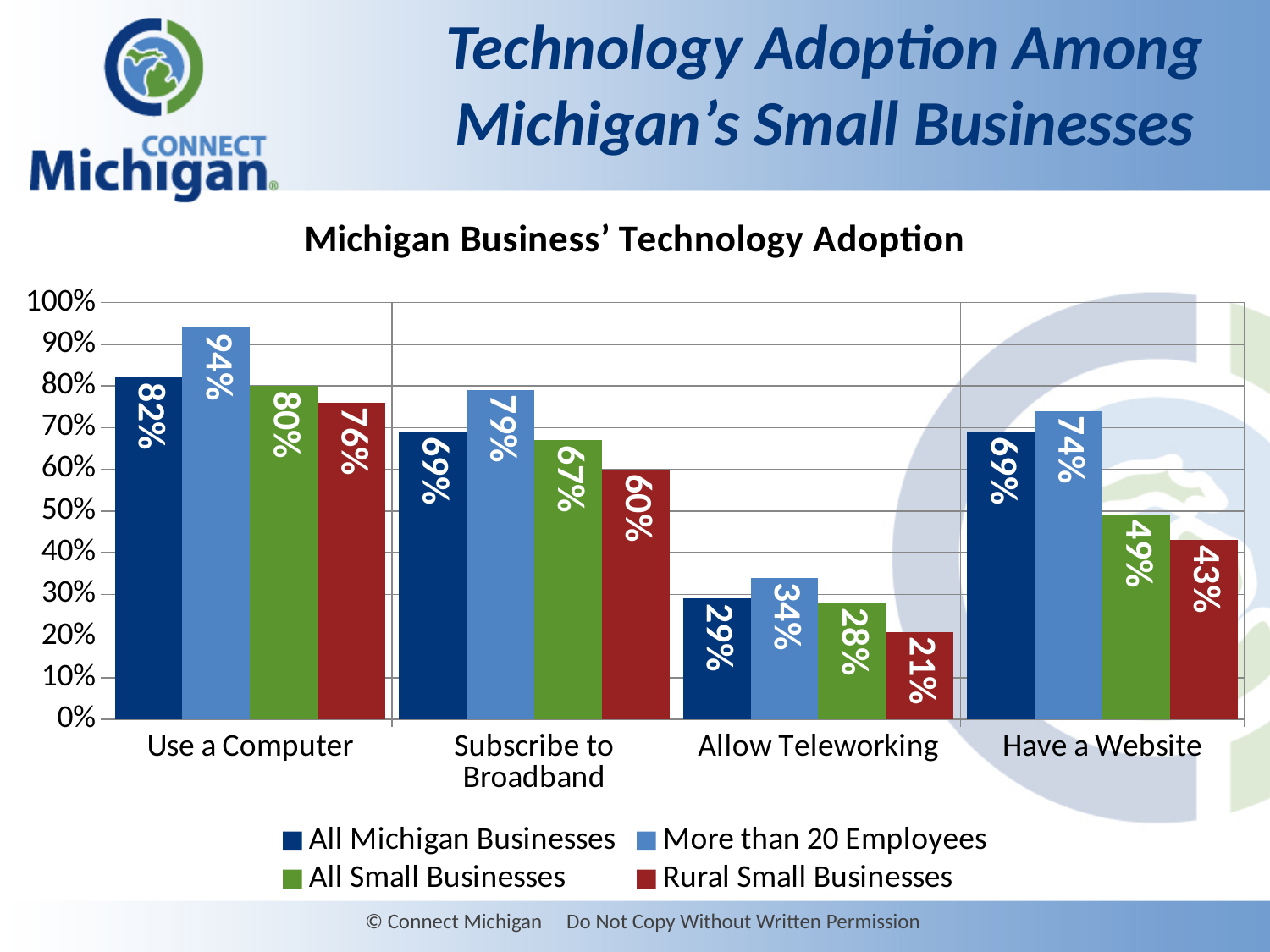
What percentage of All Small Businesses allow teleworking? 28% How many categories are shown on the x axis? 4 What is the title of the chart? Michigan Business' Technology Adoption Which category has the lowest value for Rural Small Businesses? Allow Teleworking What percentage of Rural Small Businesses subscribe to broadband? 60% What is the difference between More than 20 Employees and Rural Small Businesses in the Have a Website category? 31% What is the value for More than 20 Employees in the Use a Computer category? 94% How many series does the legend list? 4 Which series has the highest value in the Have a Website category? More than 20 Employees Which is larger: All Michigan Businesses for Subscribe to Broadband or All Small Businesses for Subscribe to Broadband? All Michigan Businesses Which series is shown in green in the legend? All Small Businesses What kind of chart is shown on the slide? Bar chart